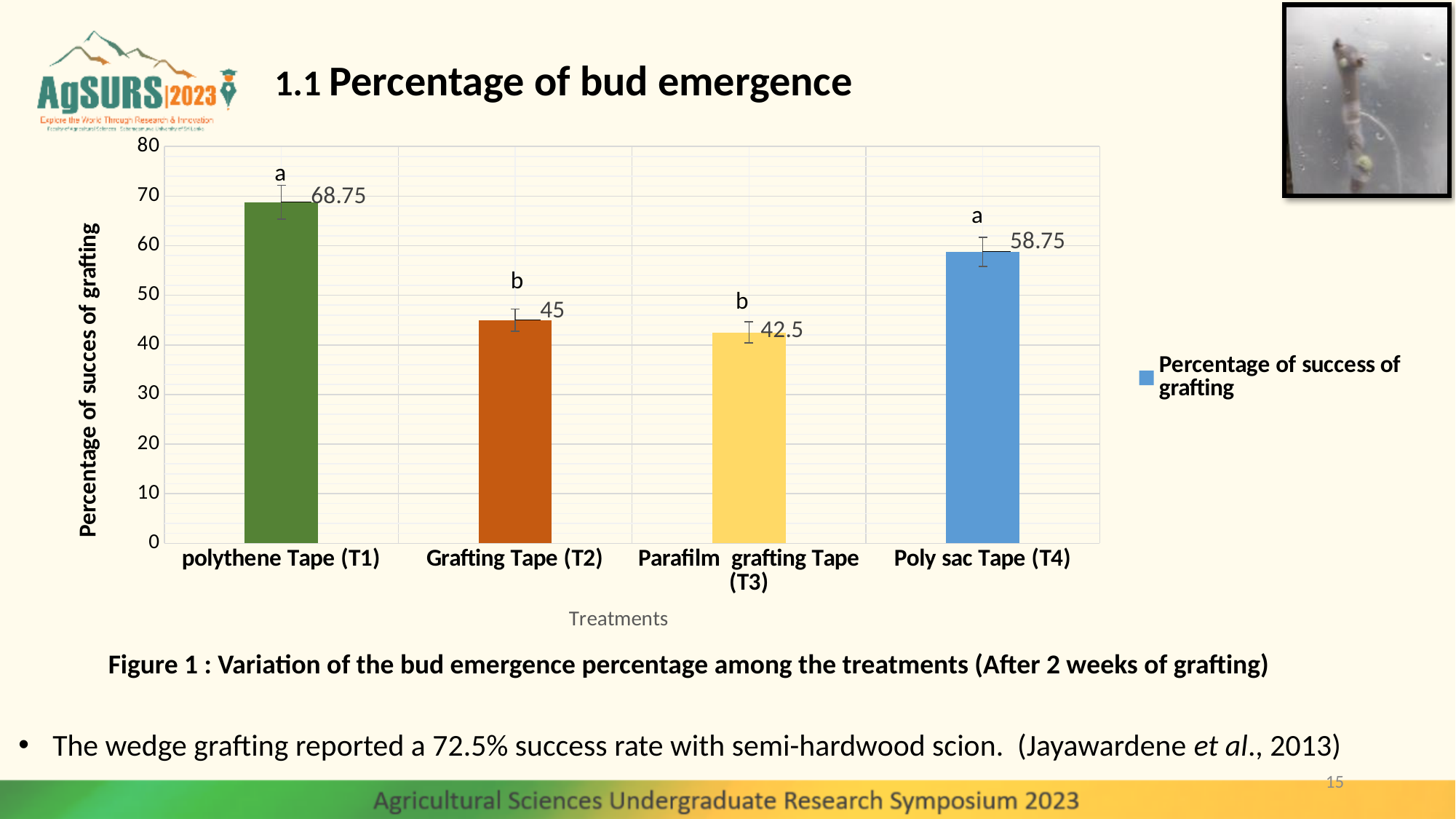
Which treatment has the lowest percentage of success of grafting? Parafilm grafting Tape (T3) What is the percentage of success of grafting for Parafilm grafting Tape (T3)? 42.5 What kind of chart is shown on the slide? bar chart How many treatments are shown on the x axis? 4 What is the label of the y axis? Percentage of succes of grafting What is the difference between the values for polythene Tape (T1) and Poly sac Tape (T4)? 10 Which has a larger value, Grafting Tape (T2) or Poly sac Tape (T4)? Poly sac Tape (T4) What is the percentage of success of grafting for Grafting Tape (T2)? 45 What is the percentage of success of grafting for polythene Tape (T1)? 68.75 Is the value for Parafilm grafting Tape (T3) greater or less than 50? less Which treatment has the highest percentage of success of grafting? polythene Tape (T1) What is the percentage of success of grafting for Poly sac Tape (T4)? 58.75